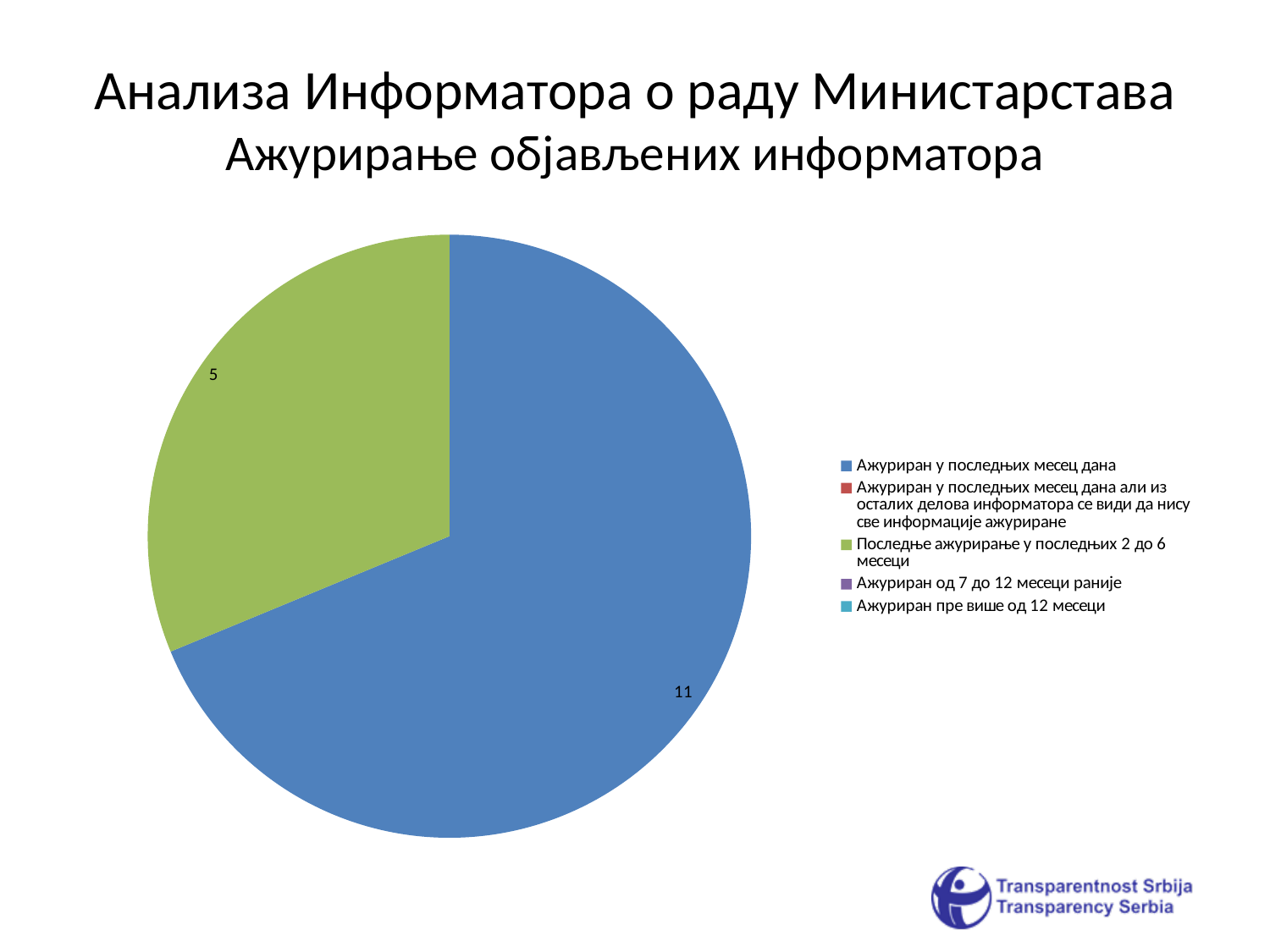
What share of the total do the 11 informators updated in the last month represent? 11 of 16 (68.75%) What colour is the slice for "Последње ажурирање у последњих 2 до 6 месеци"? green How many entries does the legend list? 5 What is the value of the slice for "Последње ажурирање у последњих 2 до 6 месеци"? 5 Which of the visible slices is the smallest? Последње ажурирање у последњих 2 до 6 месеци How many slices with data labels are visible in the pie chart? 2 What kind of chart is shown on the slide? pie chart Which category has the largest slice of the pie? Ажуриран у последњих месец дана What is the difference between the value for "Ажуриран у последњих месец дана" and the value for "Последње ажурирање у последњих 2 до 6 месеци"? 6 Which is larger: the slice for "Ажуриран у последњих месец дана" or the slice for "Последње ажурирање у последњих 2 до 6 месеци"? Ажуриран у последњих месец дана What is the total of the two labelled slices in the pie chart? 16 What is the value of the slice for "Ажуриран у последњих месец дана"? 11